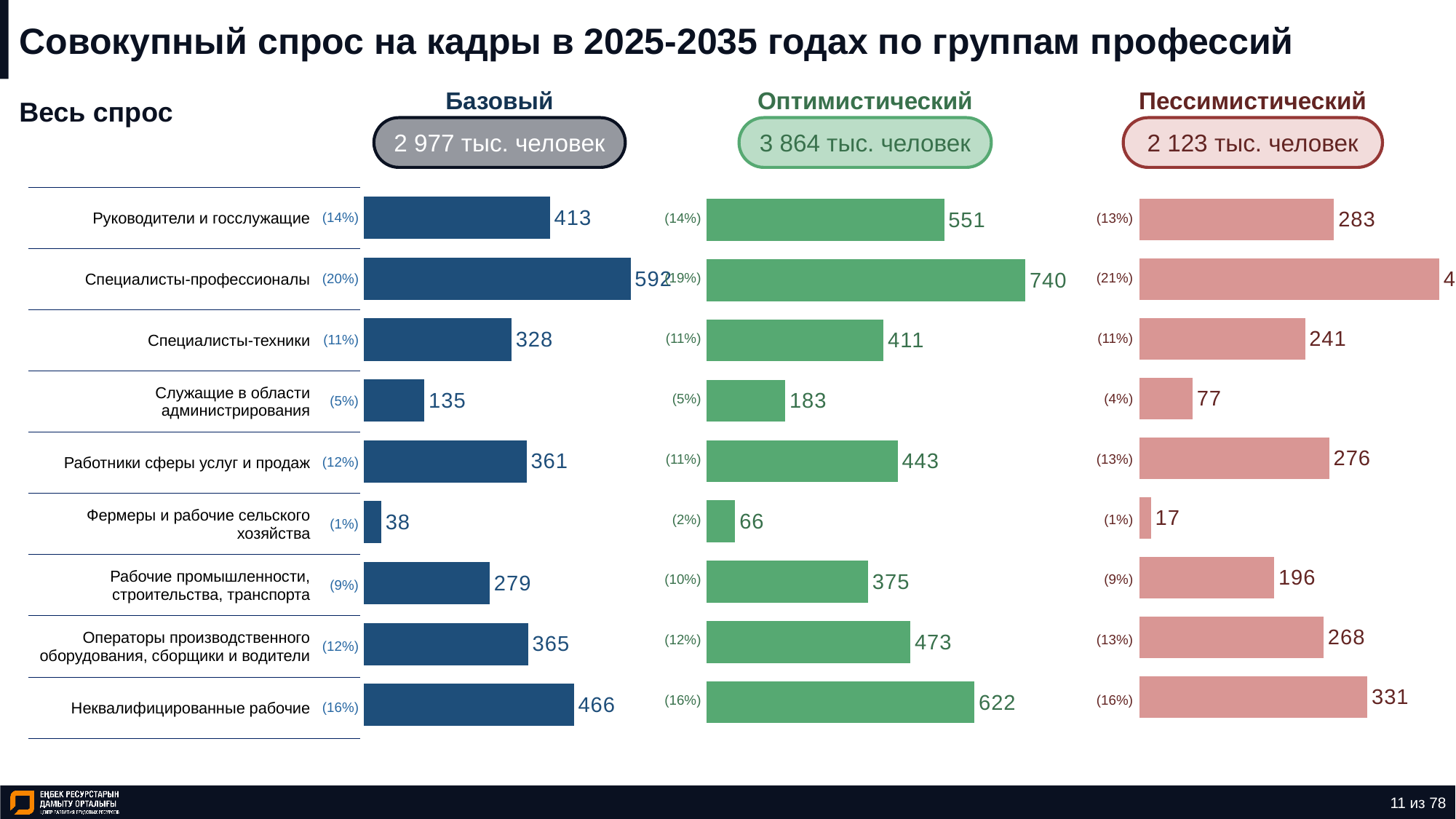
In the Оптимистический chart, what is the difference between Специалисты-профессионалы and Руководители и госслужащие? 189 In the Пессимистический chart, which category has the lowest value? Фермеры и рабочие сельского хозяйства What total is shown in the label above the Пессимистический chart? 2 123 тыс. человек In the Пессимистический chart, which is larger: Руководители и госслужащие or Работники сферы услуг и продаж? Руководители и госслужащие In the Пессимистический chart, what is the value for Специалисты-техники? 241 How many profession groups are shown in the Базовый chart? 9 What kind of chart is used for the Оптимистический scenario? Bar chart In the Оптимистический chart, which category has the lowest value? Фермеры и рабочие сельского хозяйства In the Базовый chart, what is the value for Руководители и госслужащие? 413 In the Базовый chart, what is the difference between Неквалифицированные рабочие and Специалисты-техники? 138 In the Оптимистический chart, what is the value for Неквалифицированные рабочие? 622 In the Базовый chart, which category has the highest value? Специалисты-профессионалы